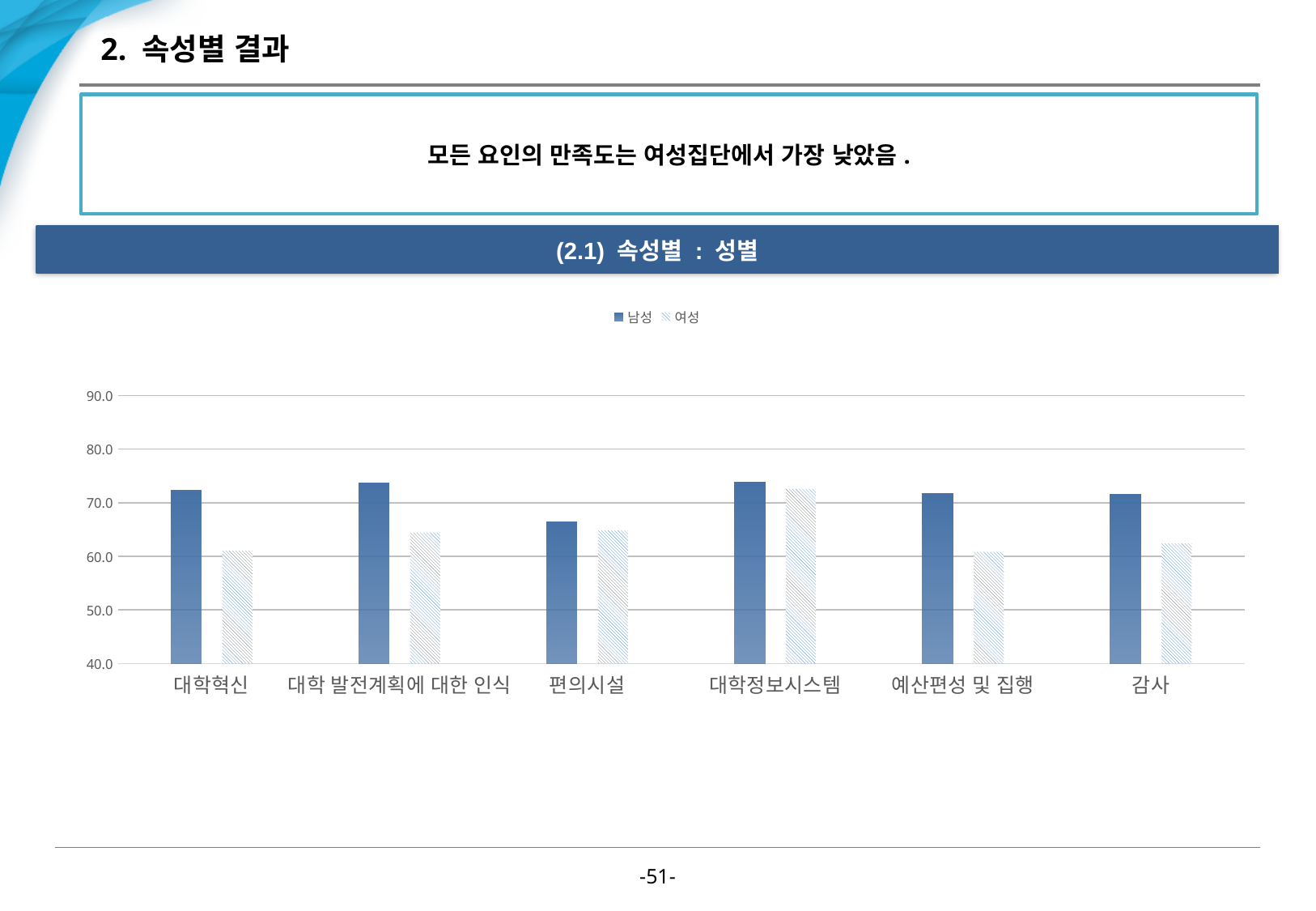
How many series does the chart legend list? 2 Is the 여성 value for 대학혁신 greater or less than 70? less Is the 여성 value for 감사 greater or less than 70? less How many categories are shown on the x axis of the chart? 6 For 대학혁신, which is larger, the 남성 value or the 여성 value? 남성 What kind of chart is shown on the slide? bar chart What are the two series named in the chart legend? 남성, 여성 Is the 남성 value for 대학혁신 greater or less than 70? greater Which category has the highest 여성 value? 대학정보시스템 Which category has the lowest 남성 value? 편의시설